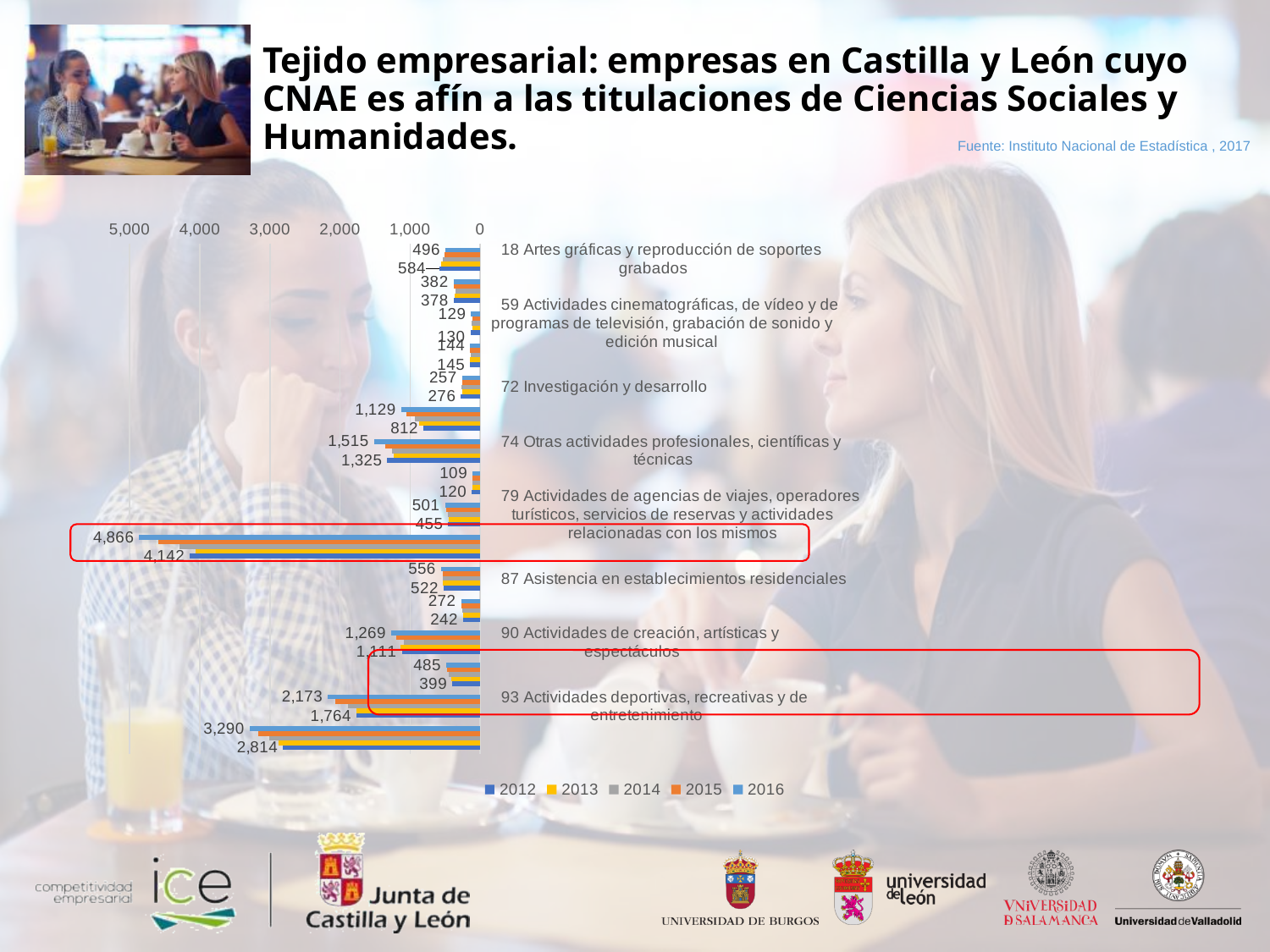
What is the difference between the labelled values 3,290 and 2,814 in the bottom group of bars? 476 How many series does the legend list? 5 What is the smallest value labelled on the chart? 109 What is the largest value labelled on the chart? 4,866 Which labelled value is larger, 485 or 399? 485 What is the highest value shown on the chart's value axis? 5,000 What is the difference between the labelled values 4,866 and 4,142 in the highlighted group of bars? 724 Is the bar labelled 4,866 greater or less than 4,000? greater What kind of chart is shown on the slide? bar chart Which labelled value is larger, 1,515 or 1,325? 1,515 Which years are listed in the chart legend? 2012, 2013, 2014, 2015, 2016 Is the bar labelled 2,173 greater or less than 2,000? greater